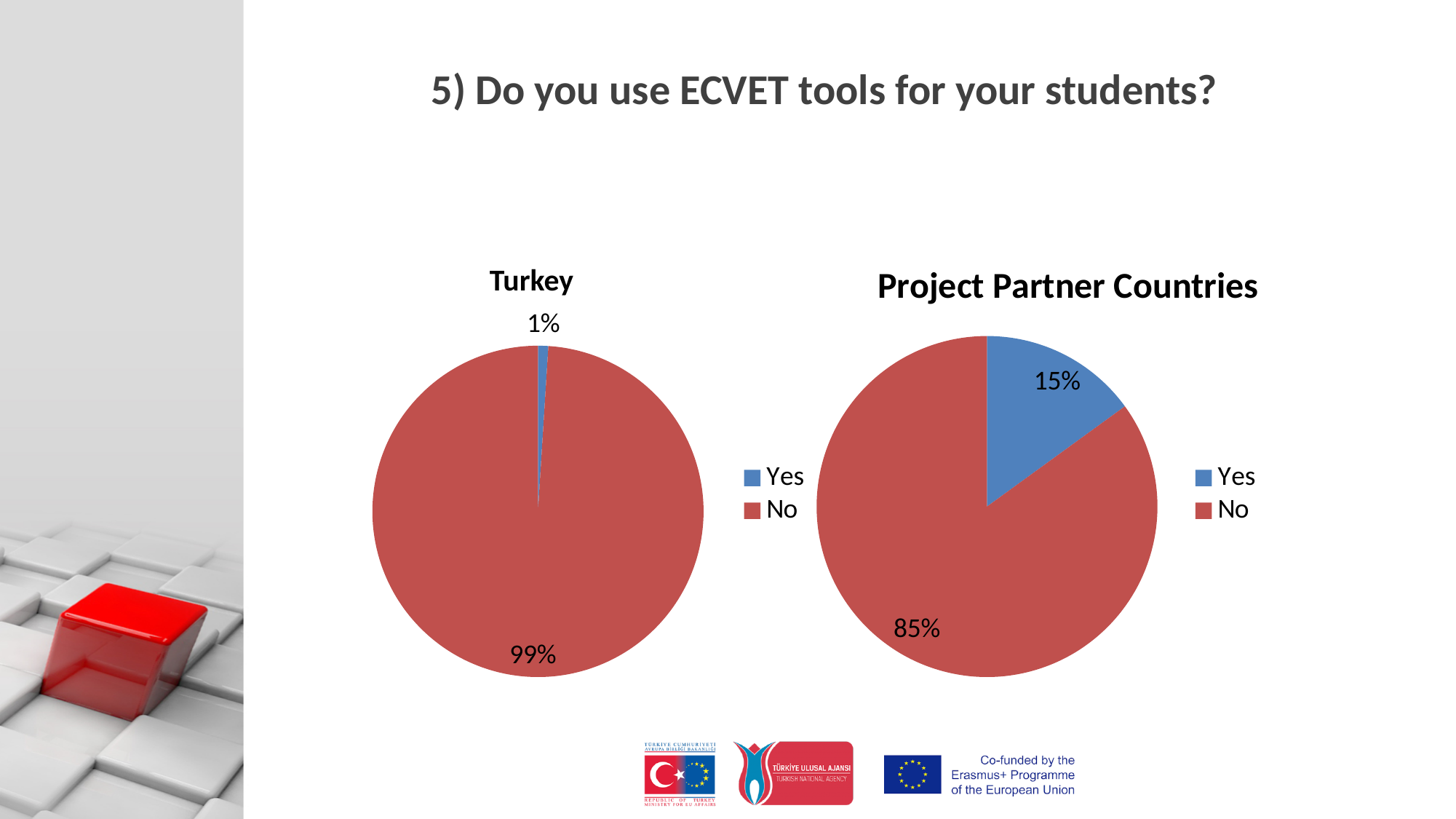
In the Turkey chart, which answer has the smallest slice? Yes In the Project Partner Countries chart, which answer has the largest slice? No What colour represents the No answer in the Project Partner Countries chart? Red In the Project Partner Countries chart, what percentage answered No? 85% In the Project Partner Countries chart, what is the difference between the No and Yes percentages? 70% How many slices does the Project Partner Countries pie chart have? 2 In the Turkey chart, what percentage answered No? 99% In the Project Partner Countries chart, what percentage answered Yes? 15% In the Turkey chart, what percentage answered Yes? 1% How many entries does the legend of the Turkey chart list? 2 Which chart has the larger Yes share, Turkey or Project Partner Countries? Project Partner Countries What type of chart is the Turkey chart? Pie chart